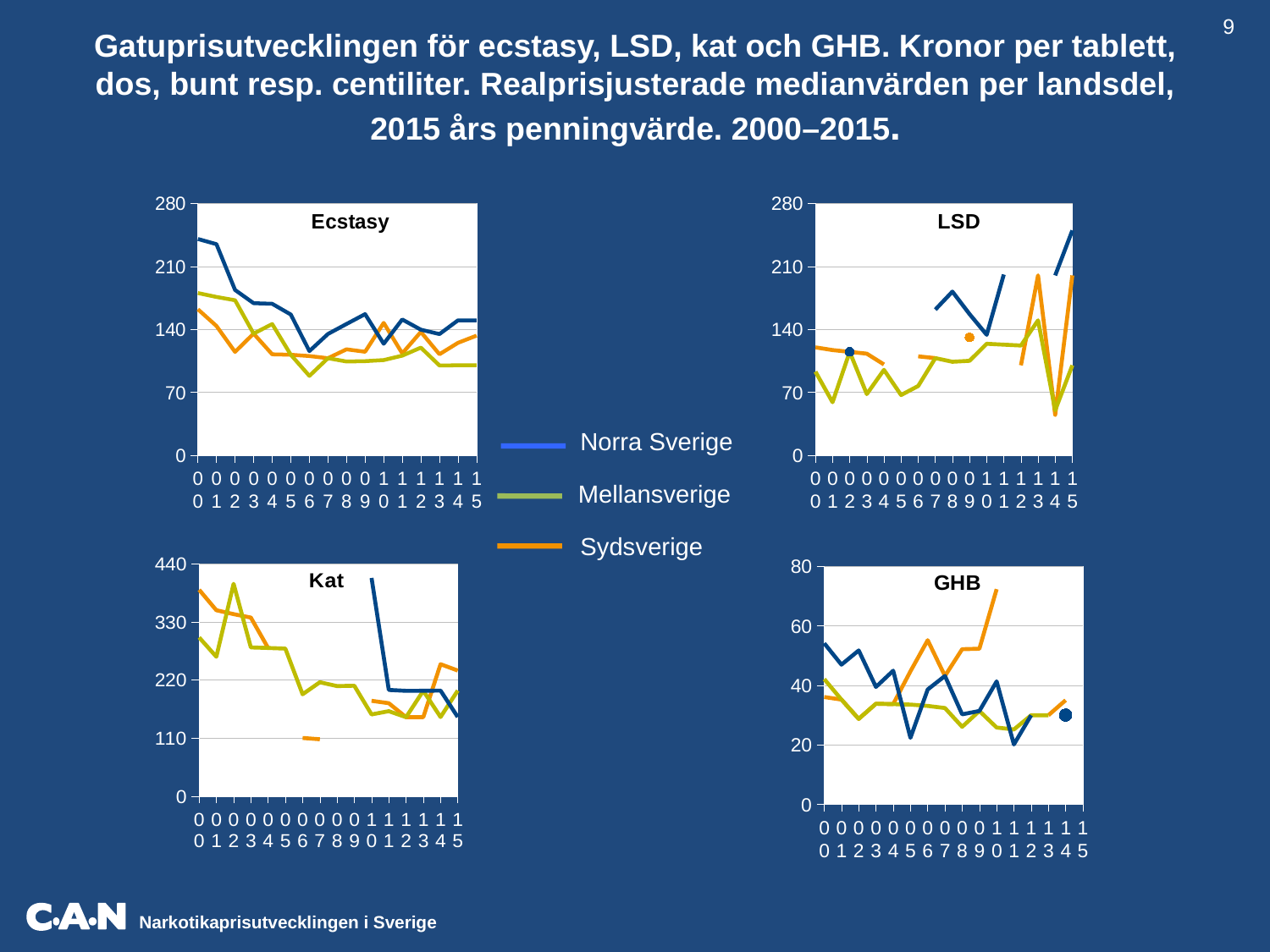
How many series does the legend list? 3 What kind of chart is the Ecstasy chart? line chart Which colour represents Sydsverige in the legend? orange In the Kat chart, does the Mellansverige line overall rise or fall from year 00 to year 15? fall In the Ecstasy chart, how many years are shown on the x axis? 16 In the LSD chart, is the value for Mellansverige in year 14 greater or less than 70? less In the Ecstasy chart, which is higher in year 00: Norra Sverige or Sydsverige? Norra Sverige In the Kat chart, is the value for Sydsverige in year 00 greater or less than 330? greater In the Ecstasy chart, is the value for Norra Sverige in year 00 greater or less than 210? greater In the Ecstasy chart, does the Norra Sverige line overall rise or fall from year 00 to year 15? fall